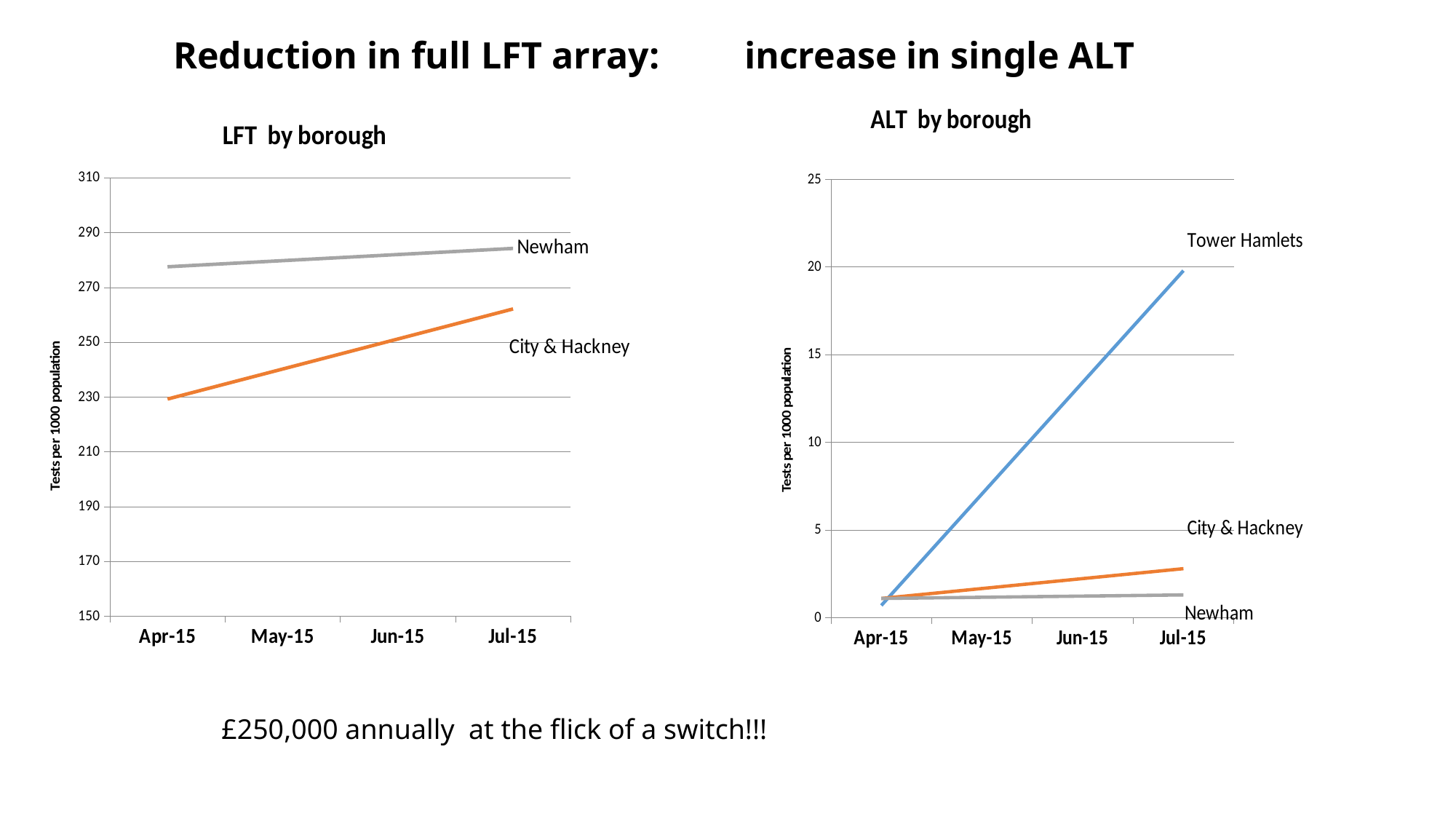
In the 'ALT by borough' chart, how many boroughs are plotted? 3 In the 'ALT by borough' chart, which borough has the highest value at Jul-15? Tower Hamlets How many months are shown on the x axis of the 'LFT by borough' chart? 4 In the 'LFT by borough' chart, how many boroughs are plotted? 2 In the 'ALT by borough' chart, which borough has the lowest value at Jul-15? Newham In the 'ALT by borough' chart, is the value for Tower Hamlets at Jul-15 greater or less than 15? greater In the 'ALT by borough' chart, does the Tower Hamlets line rise or fall from Apr-15 to Jul-15? rise What kind of chart is the 'LFT by borough' chart? line chart In the 'LFT by borough' chart, which borough has the higher line? Newham What is the y-axis label on the 'ALT by borough' chart? Tests per 1000 population In the 'LFT by borough' chart, is the value for City & Hackney at Jul-15 greater or less than 250? greater What kind of chart is the 'ALT by borough' chart? line chart